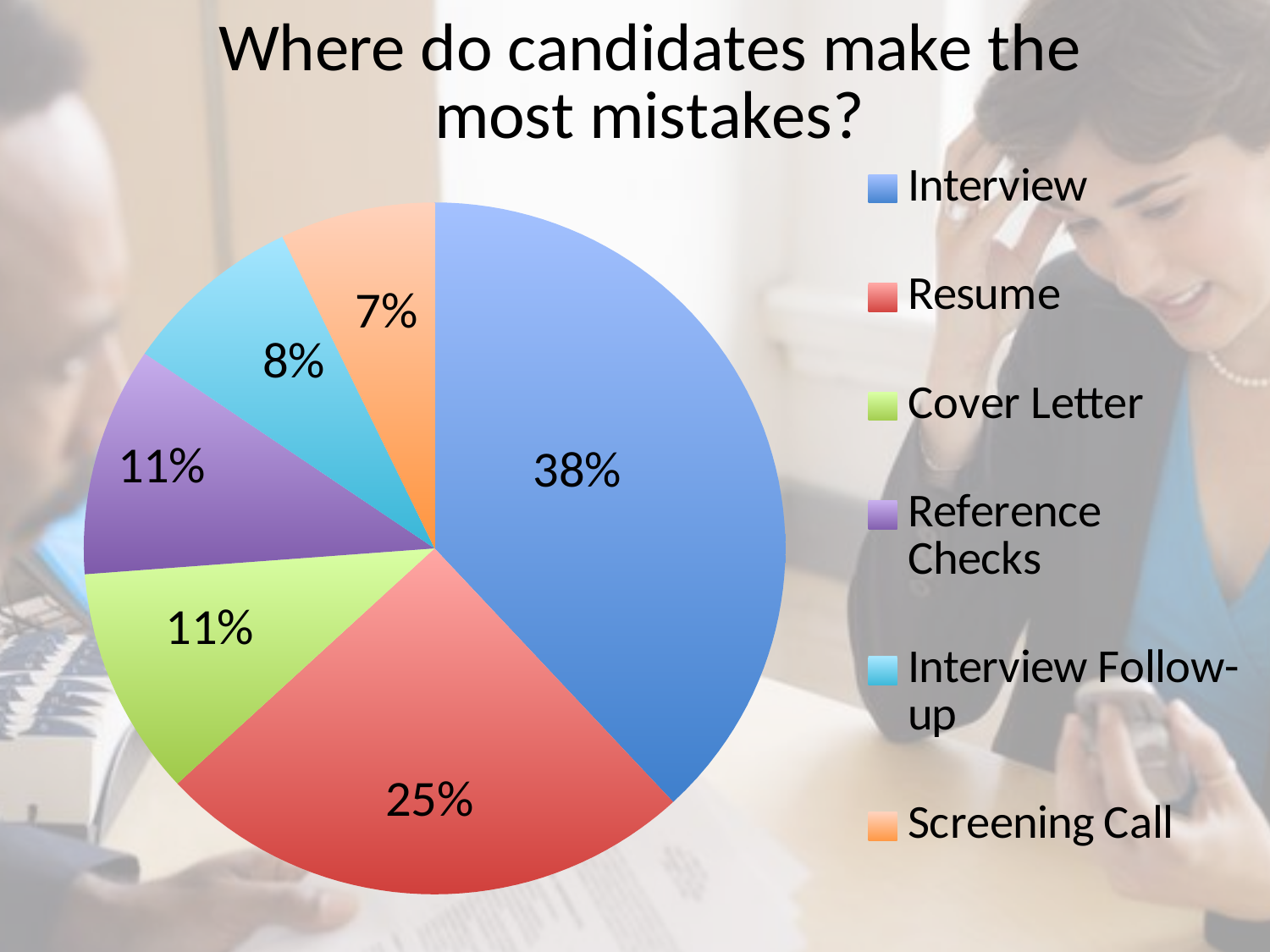
What share of the pie does Interview account for? 38% What share of the pie does Resume account for? 25% What is the title of the chart? Where do candidates make the most mistakes? Which category has the smallest slice of the pie? Screening Call What is the difference in percentage points between Interview and Resume? 13 Which category has the largest slice of the pie? Interview How many categories does the pie chart have? 6 What share of the pie does Screening Call account for? 7% What kind of chart is shown on the slide? pie chart Which is larger, the share for Resume or the share for Reference Checks? Resume